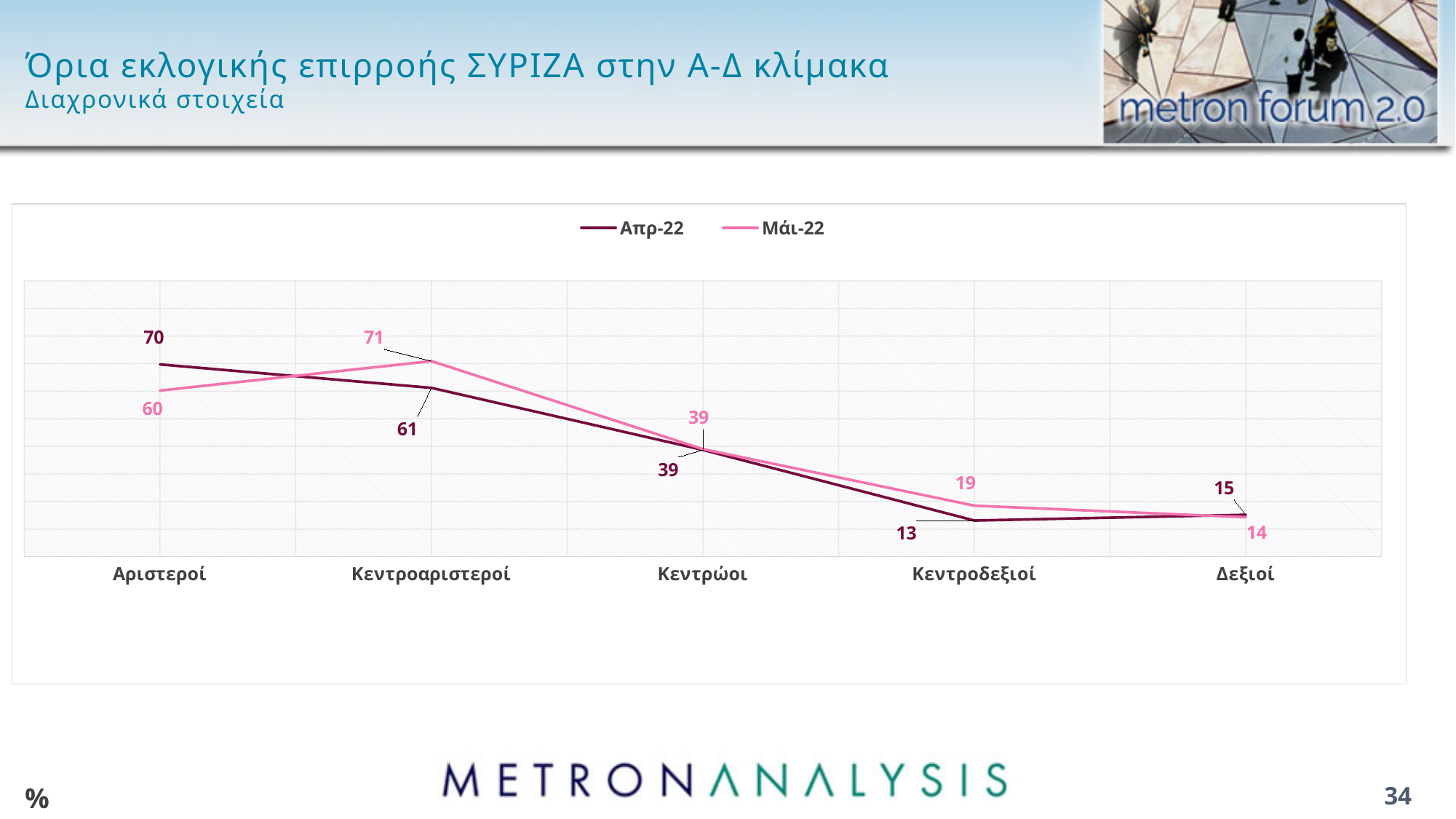
What kind of chart is shown on the slide? Line chart Do the Απρ-22 values generally rise or fall from Αριστεροί to Κεντροδεξιοί? Fall What is the value for Δεξιοί in the Μάι-22 series? 14 What is the value for Κεντροαριστεροί in the Μάι-22 series? 71 What is the value for Κεντροδεξιοί in the Απρ-22 series? 13 What is the difference between the Απρ-22 and Μάι-22 values for Αριστεροί? 10 Which series has the larger value for Κεντροαριστεροί, Απρ-22 or Μάι-22? Μάι-22 Which category has the lowest value in the Απρ-22 series? Κεντροδεξιοί Which category has the highest value in the Μάι-22 series? Κεντροαριστεροί What is the value for Αριστεροί in the Απρ-22 series? 70 How many categories are shown on the x axis? 5 How many series does the legend list? 2